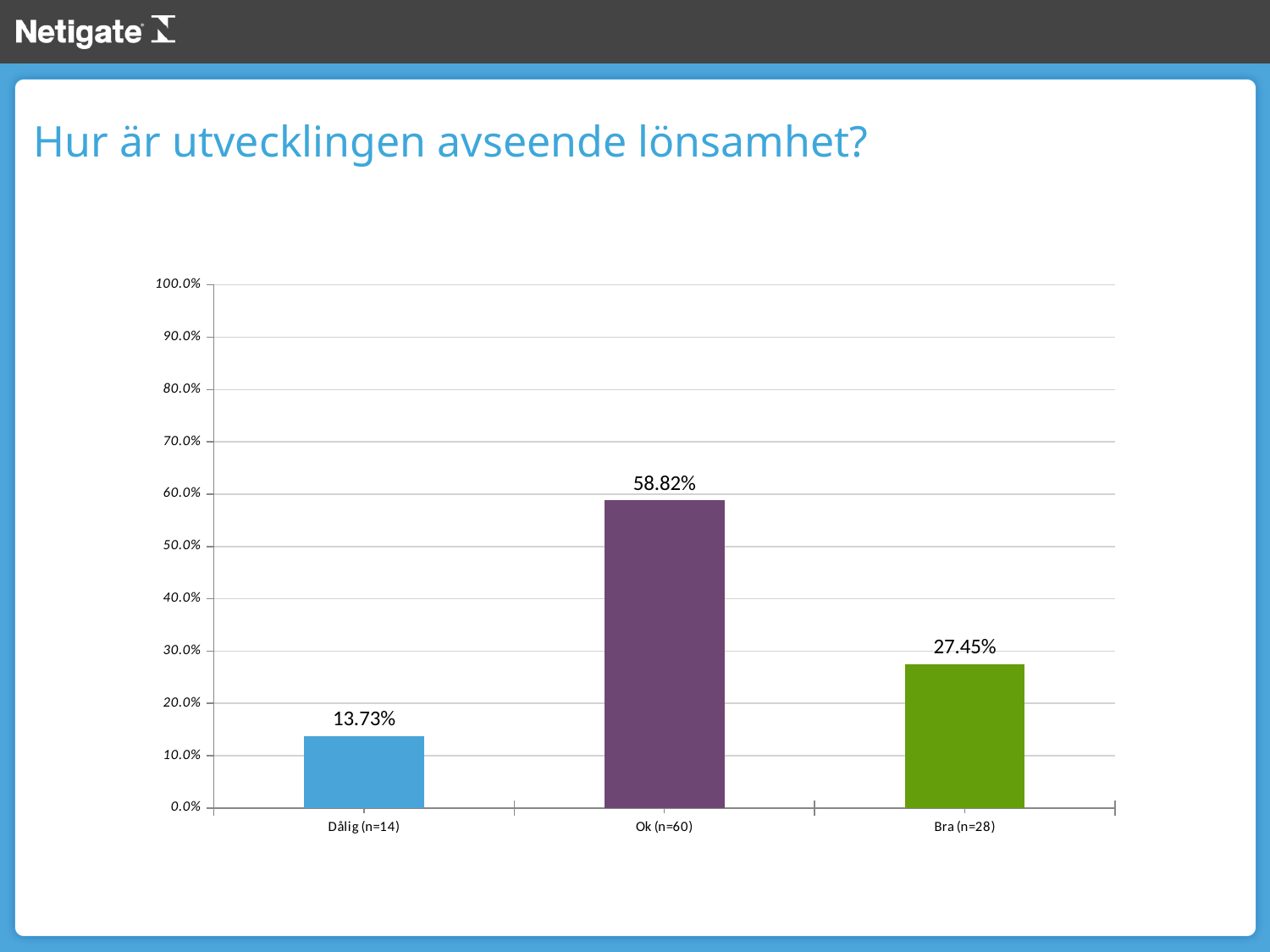
Which category has the lowest value? Dålig (n=14) What is the value for Ok (n=60)? 58.82% What kind of chart is shown on the slide? Bar chart Which is larger, the value for Bra (n=28) or the value for Dålig (n=14)? Bra (n=28) What is the title of the slide above the chart? Hur är utvecklingen avseende lönsamhet? Is the value for Ok (n=60) greater or less than 50.0%? greater What is the value for Bra (n=28)? 27.45% What is the difference between the values for Ok (n=60) and Bra (n=28)? 31.37% What is the value for Dålig (n=14)? 13.73% What is the difference between the values for Bra (n=28) and Dålig (n=14)? 13.72% How many categories are shown on the x axis? 3 Which category has the highest value? Ok (n=60)